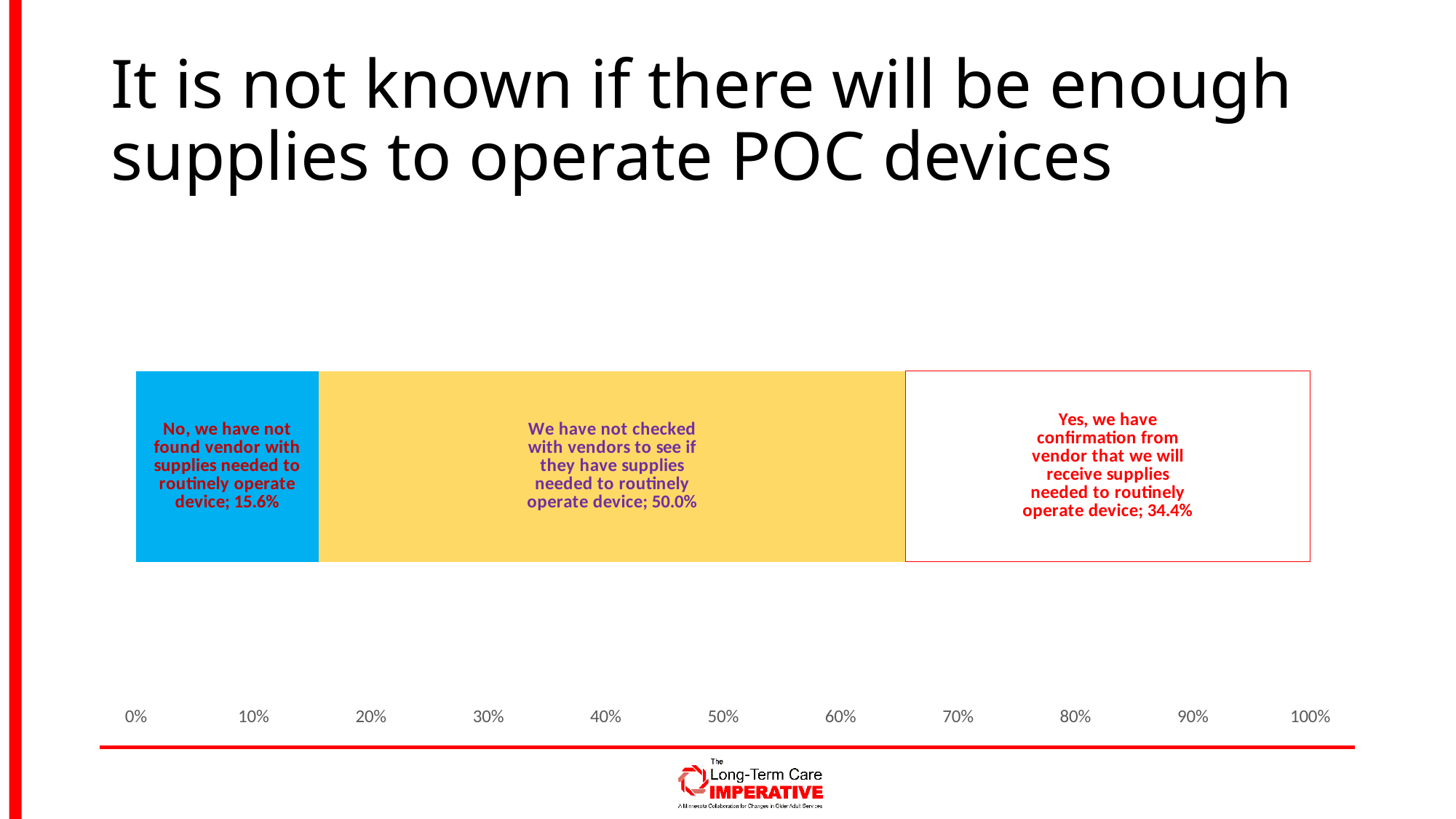
What percentage of respondents said they have not found a vendor with supplies needed to routinely operate the device? 15.6% What percentage of respondents said they have not checked with vendors to see if they have supplies needed to routinely operate the device? 50.0% What percentage of respondents said they have confirmation from a vendor that they will receive supplies needed to routinely operate the device? 34.4% Which response has the largest share in the chart? We have not checked with vendors to see if they have supplies needed to routinely operate device Which is larger: the share for 'Yes, we have confirmation from vendor' or the share for 'No, we have not found vendor'? Yes, we have confirmation from vendor What is the difference in percentage points between the 'We have not checked with vendors' segment and the 'Yes, we have confirmation from vendor' segment? 15.6 How many segments does the stacked bar contain? 3 What type of chart is shown on the slide? Stacked bar chart Which response has the smallest share in the chart? No, we have not found vendor with supplies needed to routinely operate device What is the total of the three segments in the stacked bar? 100.0% What colour is the segment for 'We have not checked with vendors to see if they have supplies needed to routinely operate device'? Yellow What is the difference in percentage points between the 'Yes, we have confirmation from vendor' segment and the 'No, we have not found vendor' segment? 18.8